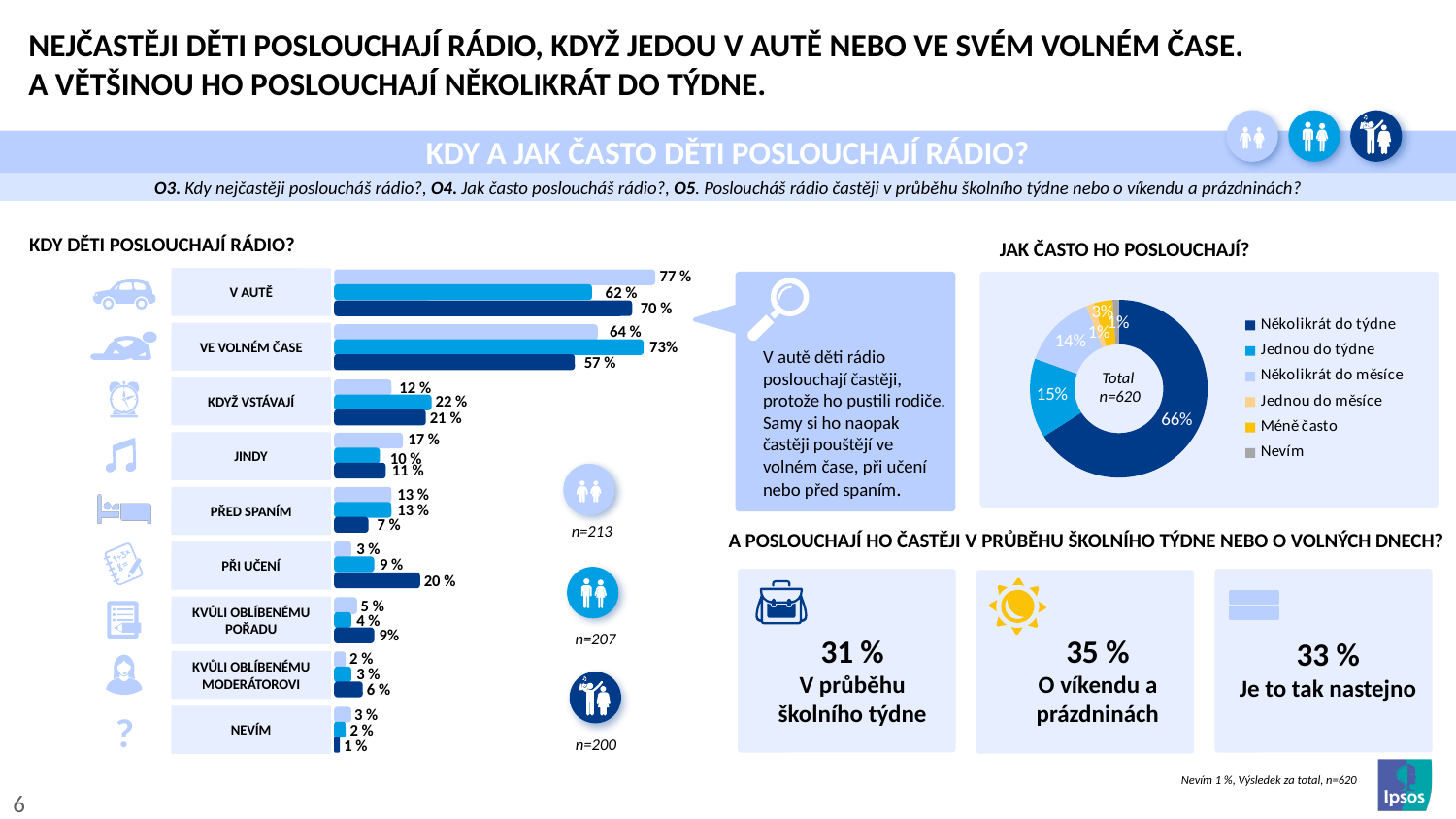
In the chart "KDY DĚTI POSLOUCHAJÍ RÁDIO?", what is the value of the bottom (dark blue) bar for "PŘI UČENÍ"? 20 % How many categories are shown in the chart "KDY DĚTI POSLOUCHAJÍ RÁDIO?"? 9 In the chart "JAK ČASTO HO POSLOUCHAJÍ?", what is the value for "Jednou do týdne"? 15% What is the total sample size shown in the centre of the chart "JAK ČASTO HO POSLOUCHAJÍ?"? n=620 In the chart "KDY DĚTI POSLOUCHAJÍ RÁDIO?", what is the value of the middle bar for "VE VOLNÉM ČASE"? 73 % How many entries does the legend of the chart "JAK ČASTO HO POSLOUCHAJÍ?" list? 6 In the chart "KDY DĚTI POSLOUCHAJÍ RÁDIO?", which is larger for "KDYŽ VSTÁVAJÍ": the top (light blue) bar or the middle bar? the middle bar In the chart "KDY DĚTI POSLOUCHAJÍ RÁDIO?", what is the difference between the top (light blue) bar and the bottom (dark blue) bar for "V AUTĚ"? 7 % In the chart "KDY DĚTI POSLOUCHAJÍ RÁDIO?", what is the value of the top (light blue) bar for "V AUTĚ"? 77 % In the chart "JAK ČASTO HO POSLOUCHAJÍ?", what share is "Několikrát do týdne"? 66% What type of chart is "KDY DĚTI POSLOUCHAJÍ RÁDIO?"? bar chart In the chart "KDY DĚTI POSLOUCHAJÍ RÁDIO?", which category has the highest value for the top (light blue) bars? V AUTĚ